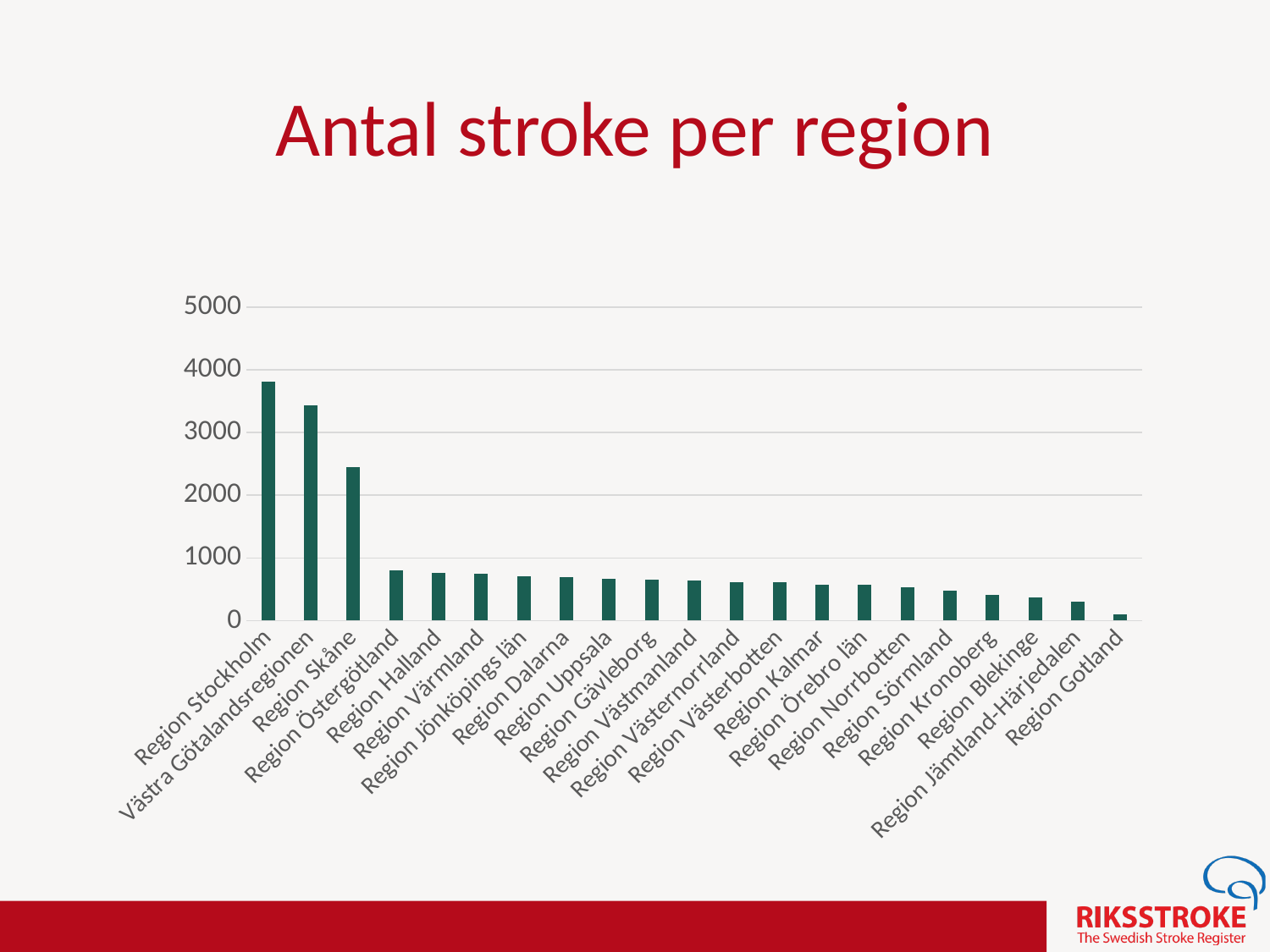
Which region has the lowest number of strokes? Region Gotland Is the value for Region Skåne greater or less than 3000? less Which region has the highest number of strokes? Region Stockholm How many regions are shown on the x axis of the chart? 21 Which has more strokes, Region Skåne or Region Halland? Region Skåne Is the value for Västra Götalandsregionen greater or less than 3000? greater Is the value for Region Stockholm greater or less than 3000? greater What kind of chart is shown on the slide? bar chart What is the title of the chart? Antal stroke per region Do the values rise or fall from left to right along the x axis? fall